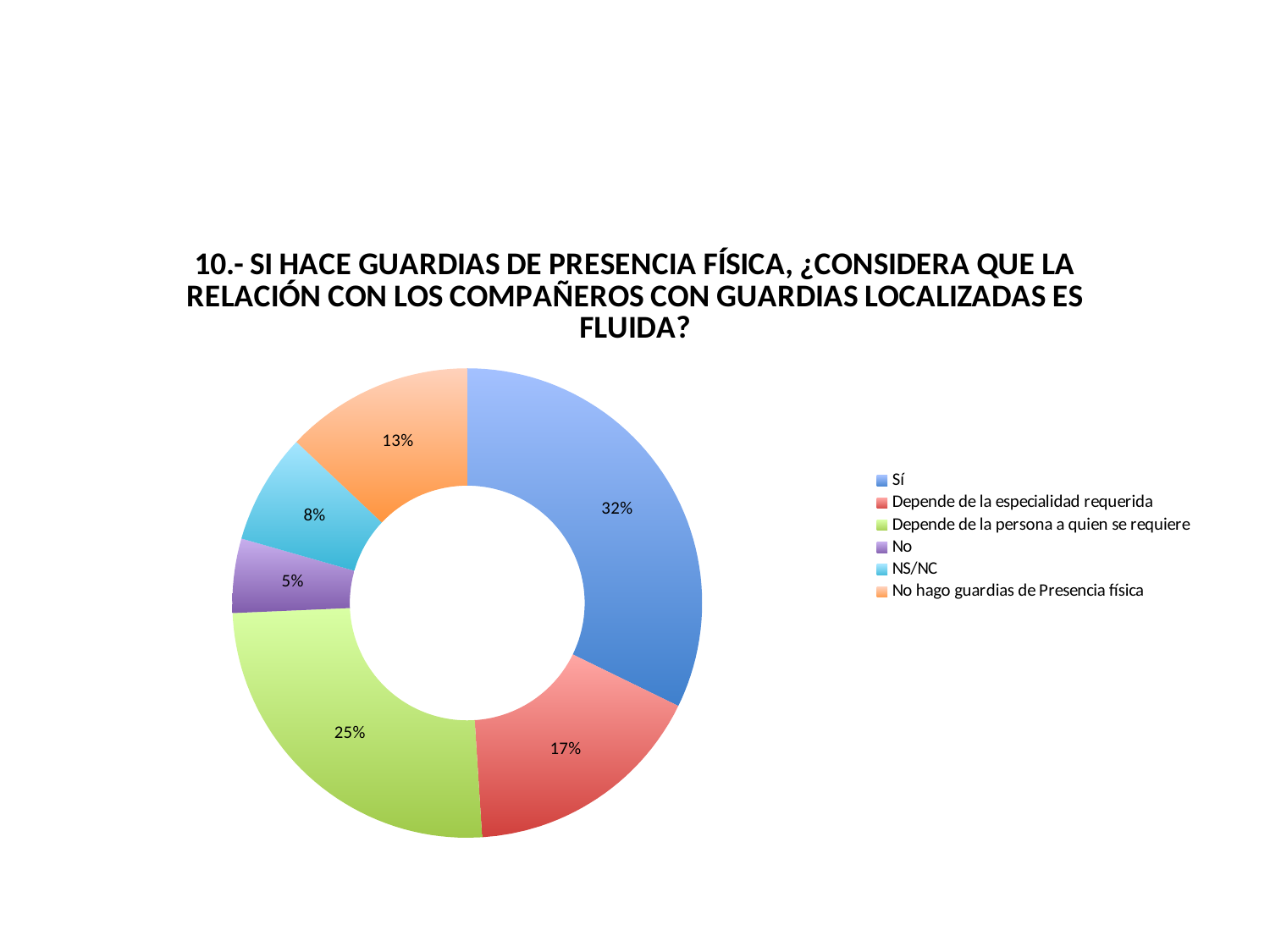
What percentage of responses is "Sí"? 32% What percentage of responses is "Depende de la persona a quien se requiere"? 25% Which response category has the largest share? Sí What kind of chart is shown on the slide? Doughnut (pie) chart What percentage of responses is "Depende de la especialidad requerida"? 17% Which is larger, the share for "NS/NC" or the share for "No hago guardias de Presencia física"? No hago guardias de Presencia física What percentage of responses is "NS/NC"? 8% What is the difference in percentage points between "Sí" and "Depende de la persona a quien se requiere"? 7 How many categories does the legend list? 6 What percentage of responses is "No hago guardias de Presencia física"? 13% What percentage of responses is "No"? 5% Which response category has the smallest share? No